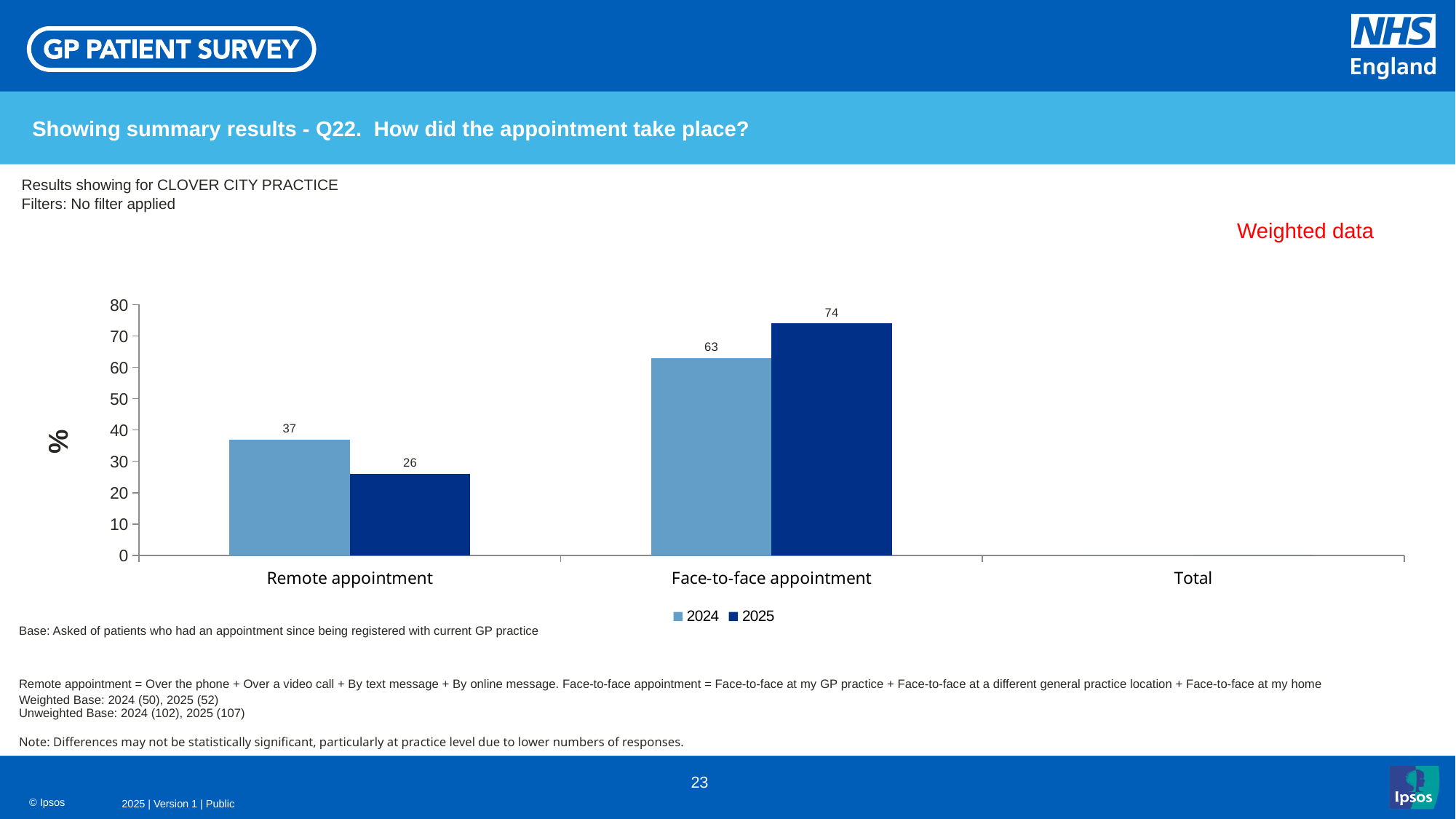
What is the 2024 value for Face-to-face appointment? 63 Which category has the highest 2025 value? Face-to-face appointment What is the 2025 value for Face-to-face appointment? 74 Which is larger for Face-to-face appointment, the 2024 value or the 2025 value? 2025 What is the difference between the 2025 and 2024 values for Face-to-face appointment? 11 What is the 2025 value for Remote appointment? 26 What is the label on the vertical axis of the chart? % What kind of chart is shown on the slide? Bar chart What is the difference between the 2024 and 2025 values for Remote appointment? 11 Which category has the lowest 2024 value? Remote appointment How many series does the legend list? 2 What is the 2024 value for Remote appointment? 37